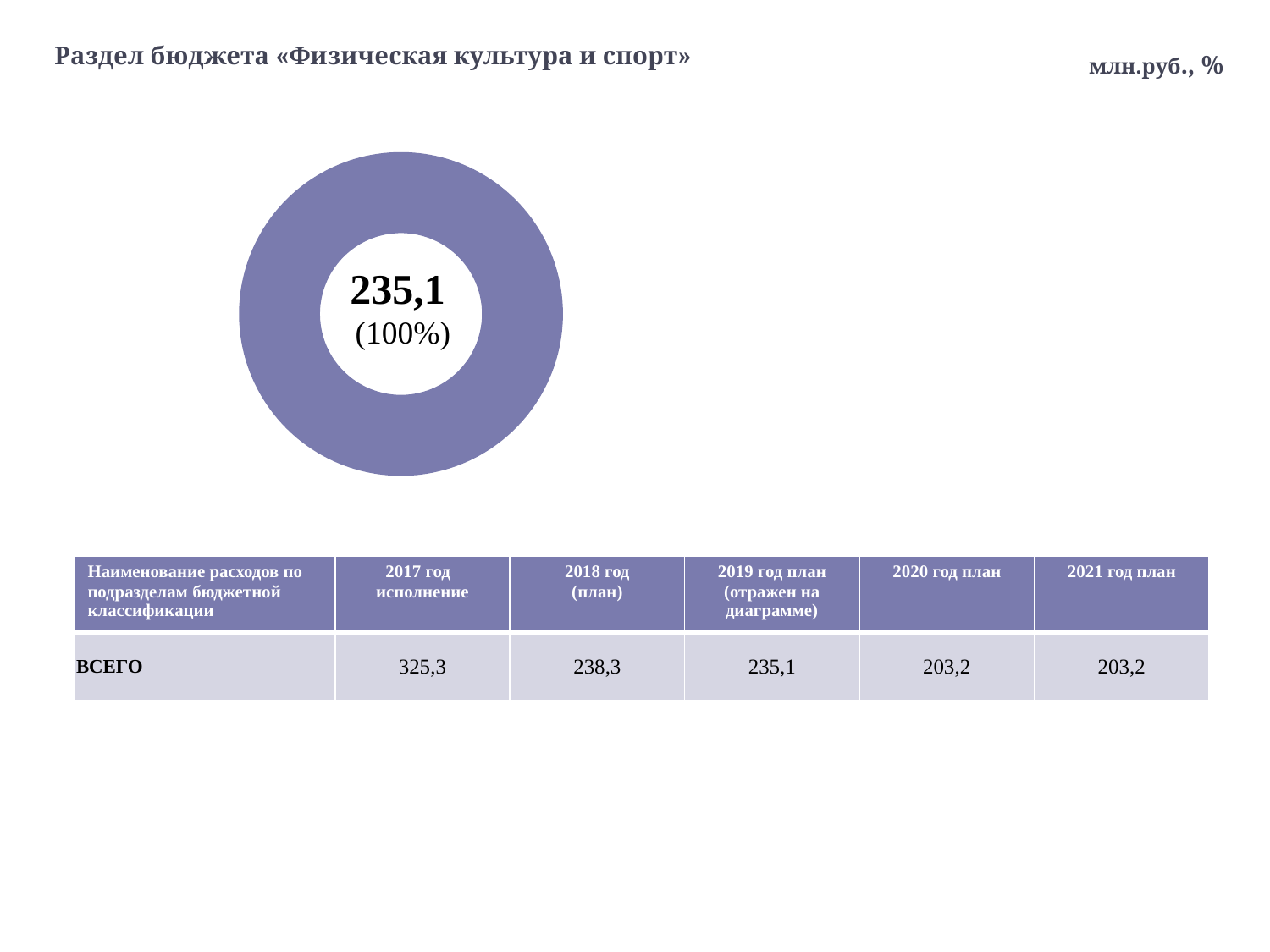
How many slices does the donut chart contain? 1 What kind of chart is shown on the slide? pie chart (donut) What value is printed in the centre of the donut chart? 235,1 What share of the donut chart does the single slice represent? 100% What units are indicated in the top-right corner of the slide for the chart values? млн.руб., % Which year's value does the donut chart reflect, according to the table header? 2019 год план